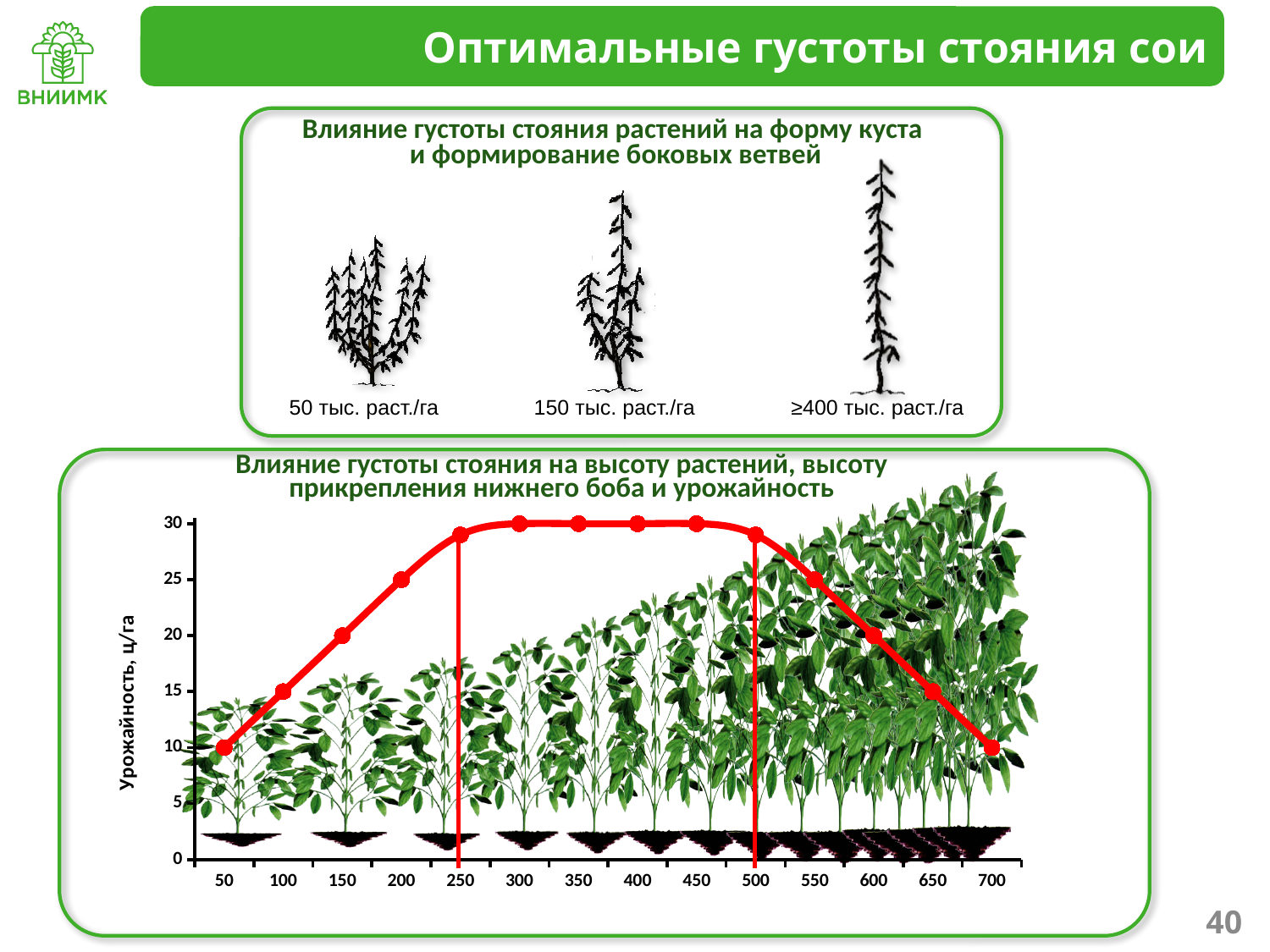
What is the yield value (ц/га) at a plant density of 400 on the chart? 30 Is the yield value at a plant density of 250 greater or less than 25? greater What is the yield value (ц/га) at a plant density of 650 on the chart? 15 Is the yield value at a plant density of 550 greater or less than 30? less What is the difference in yield (ц/га) between plant density 200 and plant density 50? 15 What is the yield value (ц/га) at a plant density of 200 on the chart? 25 Which has the higher yield on the chart: plant density 100 or plant density 600? 600 What is the yield value (ц/га) at a plant density of 50 on the chart? 10 What kind of chart is shown in the lower panel of the slide? line chart What is the label of the vertical axis of the chart? Урожайность, ц/га Do the yield values rise or fall as plant density increases from 550 to 700? fall What is the yield value (ц/га) at a plant density of 150 on the chart? 20